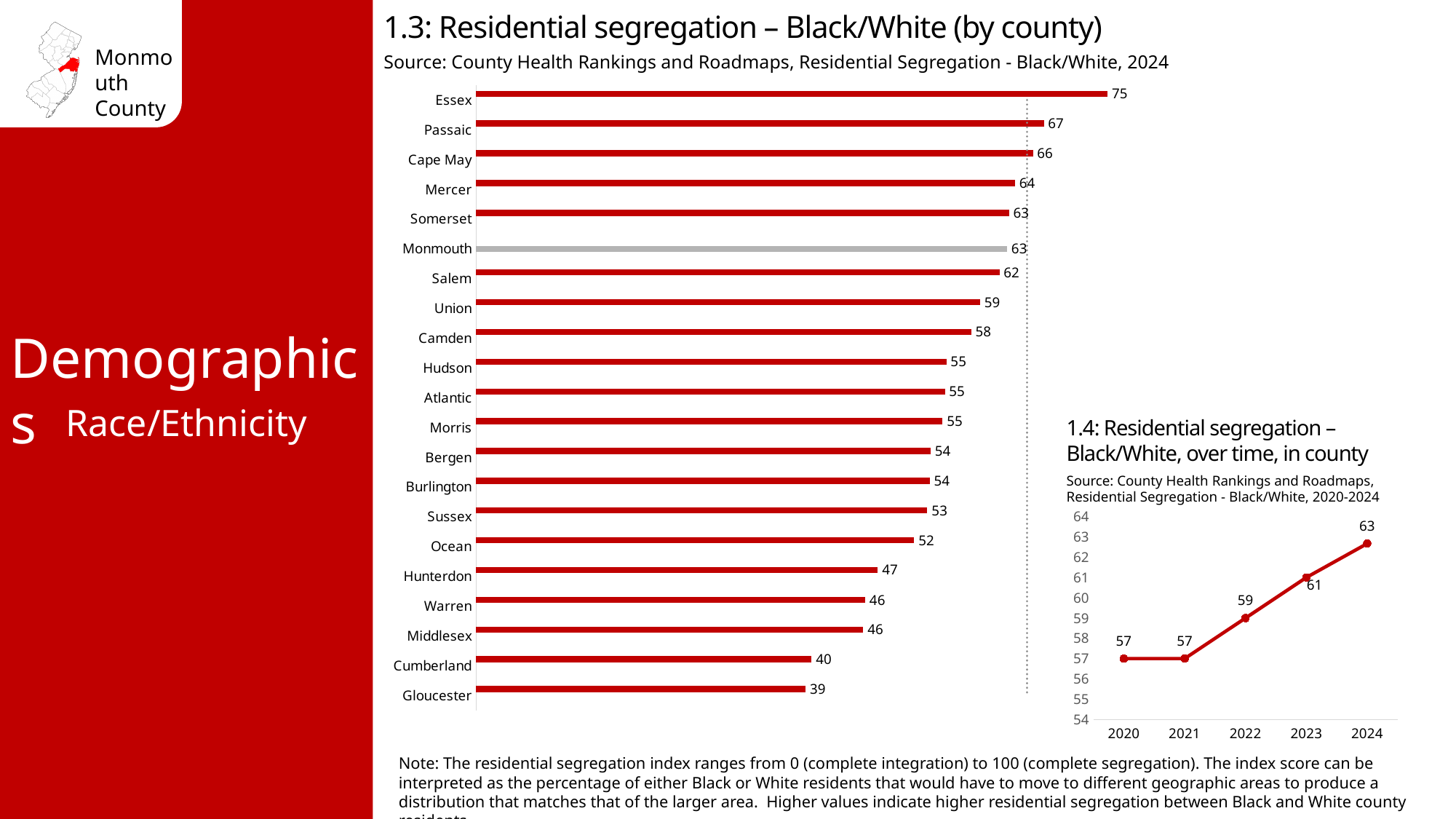
In chart 1.3 (Residential segregation – Black/White by county), how many counties are shown? 21 In chart 1.3 (Residential segregation – Black/White by county), what is the difference between the values for Essex and Gloucester? 36 In chart 1.4 (Residential segregation – Black/White, over time, in county), do the values rise or fall from 2021 to 2024? Rise In chart 1.3 (Residential segregation – Black/White by county), which county has the highest value? Essex In chart 1.3 (Residential segregation – Black/White by county), which county has the lowest value? Gloucester What kind of chart is chart 1.3 (Residential segregation – Black/White by county)? Bar chart In chart 1.4 (Residential segregation – Black/White, over time, in county), what is the value for 2022? 59 In chart 1.4 (Residential segregation – Black/White, over time, in county), how many years are plotted? 5 In chart 1.3 (Residential segregation – Black/White by county), what is the value for Monmouth? 63 In chart 1.3 (Residential segregation – Black/White by county), which has a larger value, Passaic or Ocean? Passaic In chart 1.3 (Residential segregation – Black/White by county), what is the value for Cumberland? 40 In chart 1.4 (Residential segregation – Black/White, over time, in county), what is the difference between the 2024 and 2020 values? 6